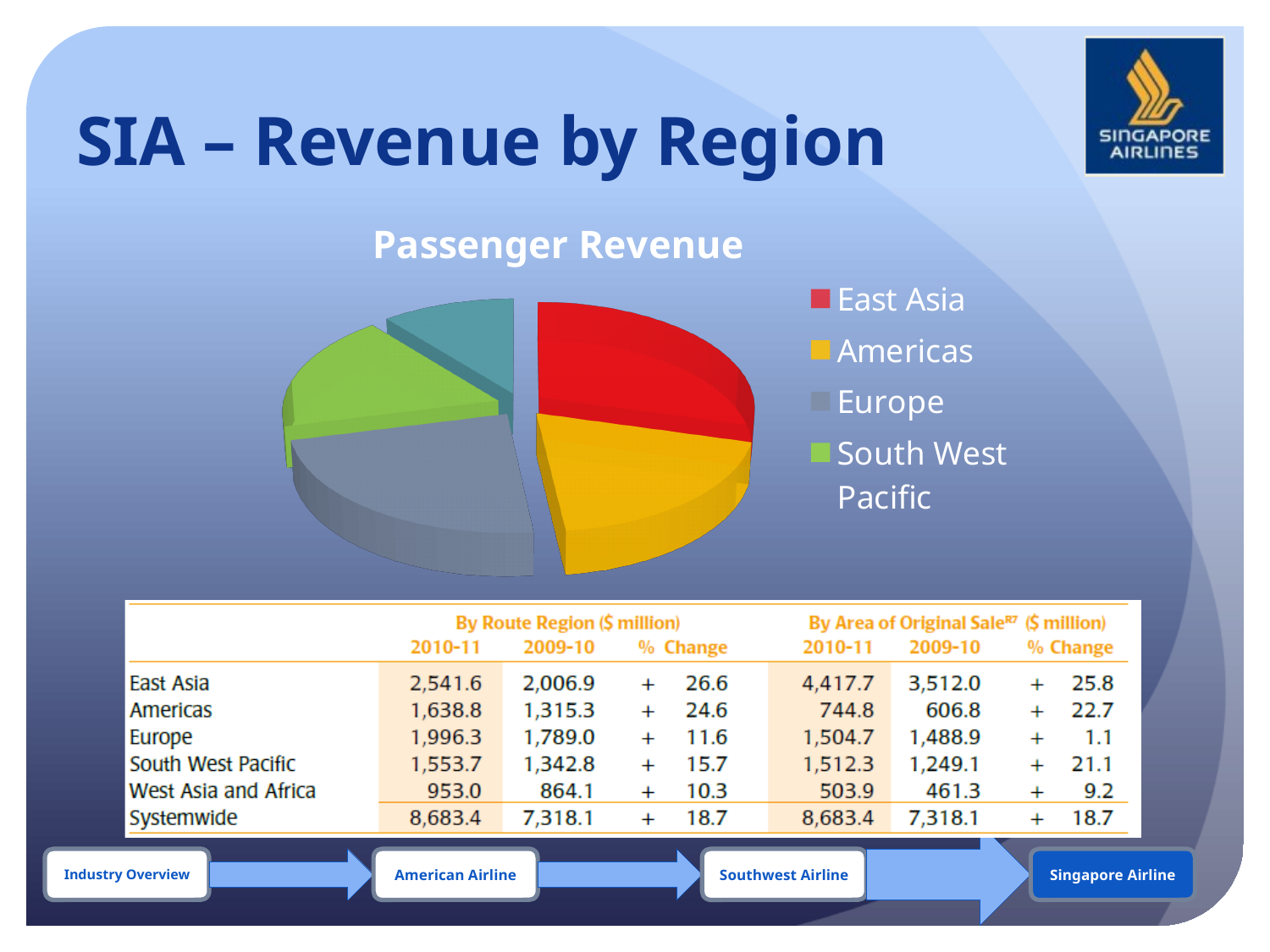
In the Passenger Revenue pie chart, which slice is larger: East Asia or South West Pacific? East Asia Which region has the largest slice in the Passenger Revenue pie chart? East Asia How many entries does the legend of the pie chart list? 4 What is the title of the pie chart? Passenger Revenue In the Passenger Revenue pie chart, which slice is larger: East Asia or Americas? East Asia What kind of chart is shown on the slide? pie chart What colour represents East Asia in the pie chart? red